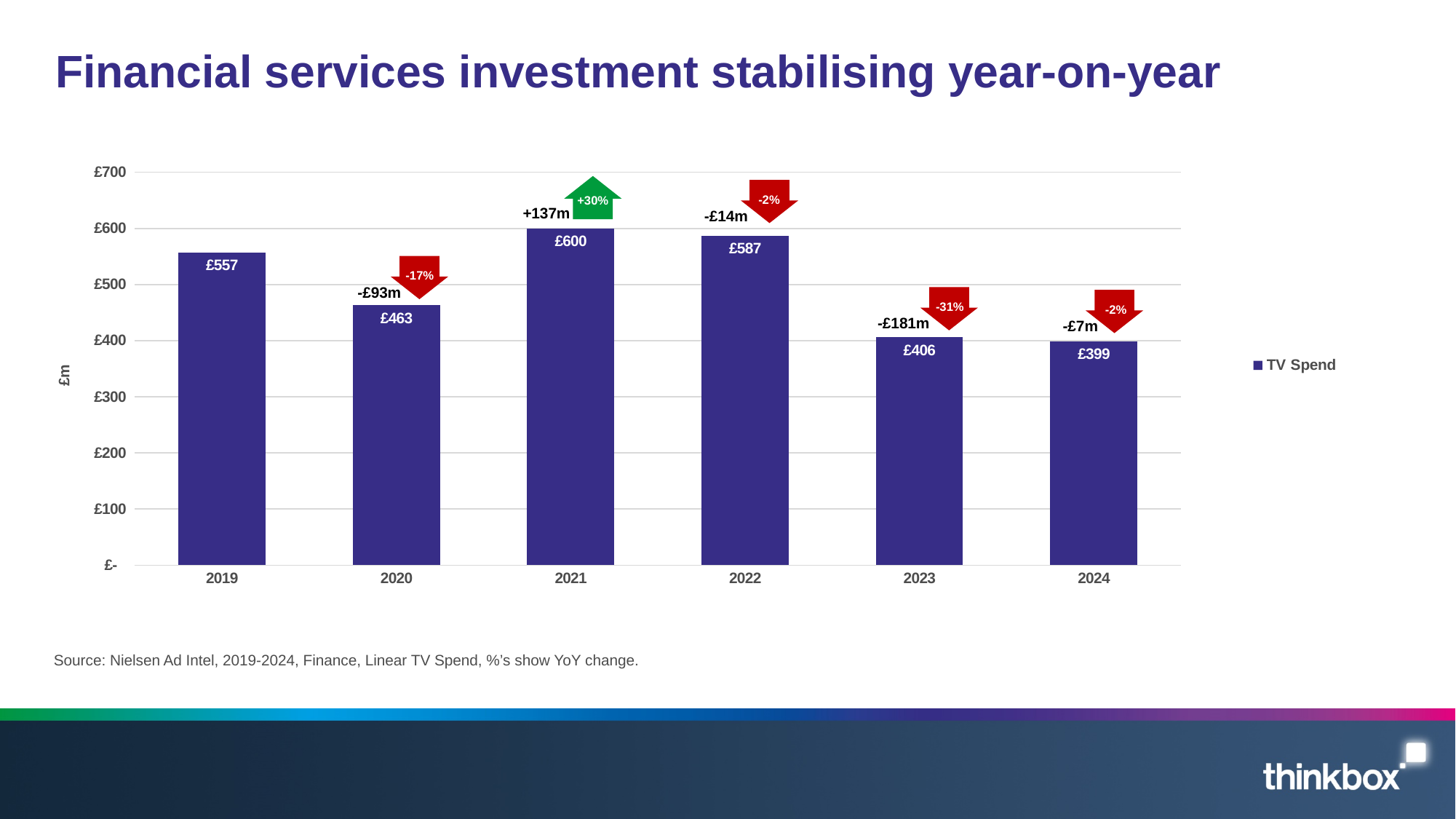
Is the TV Spend value for 2023 greater or less than £500? less Which year has a larger TV Spend, 2020 or 2022? 2022 Which year has the highest TV Spend? 2021 What kind of chart is shown on the slide? bar chart What is the difference in TV Spend between 2022 and 2023? £181 How many years are shown on the x axis? 6 What is the TV Spend value for 2021? £600 What is the TV Spend value for 2019? £557 What year-on-year percentage change is shown above the 2023 bar? -31% How many series does the legend list? 1 Which year has the lowest TV Spend? 2024 What is the TV Spend value for 2024? £399